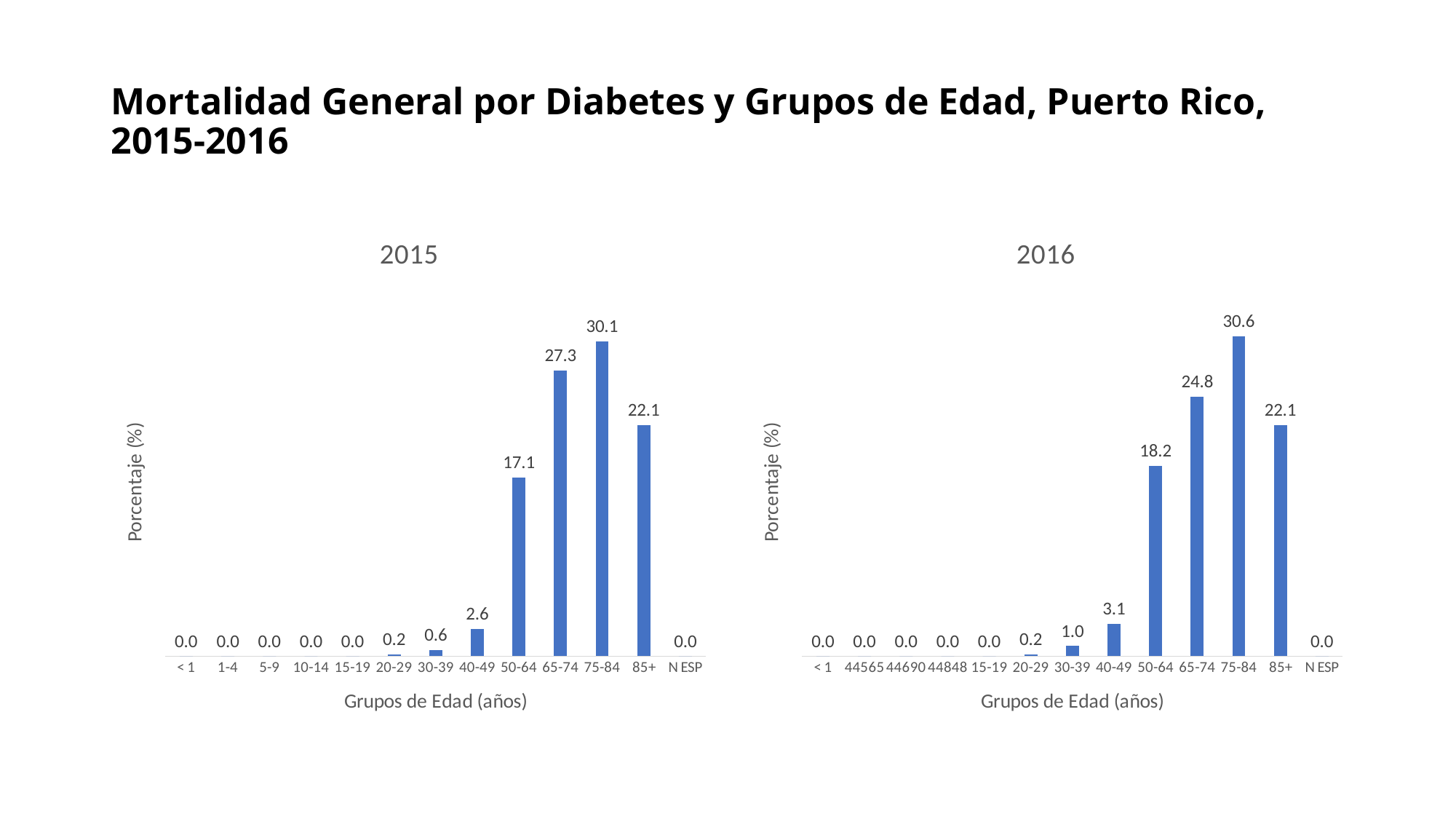
What type of chart is the 2016 chart? Bar chart In the 2016 chart, which is larger, the value for 65-74 or the value for 85+? 65-74 In the 2015 chart, how many age-group categories are shown on the x axis? 13 In the 2015 chart, what is the value for the 75-84 age group? 30.1 In the 2015 chart, which age group has the highest value? 75-84 In the 2016 chart, what is the difference between the values for 75-84 and 65-74? 5.8 What is the y-axis label of the 2015 chart? Porcentaje (%) In the 2016 chart, what is the value for the 30-39 age group? 1.0 In the 2016 chart, what is the value for the 50-64 age group? 18.2 In the 2015 chart, what is the difference between the values for 65-74 and 50-64? 10.2 In the 2016 chart, which age group has the highest value? 75-84 In the 2015 chart, what is the value for the 40-49 age group? 2.6